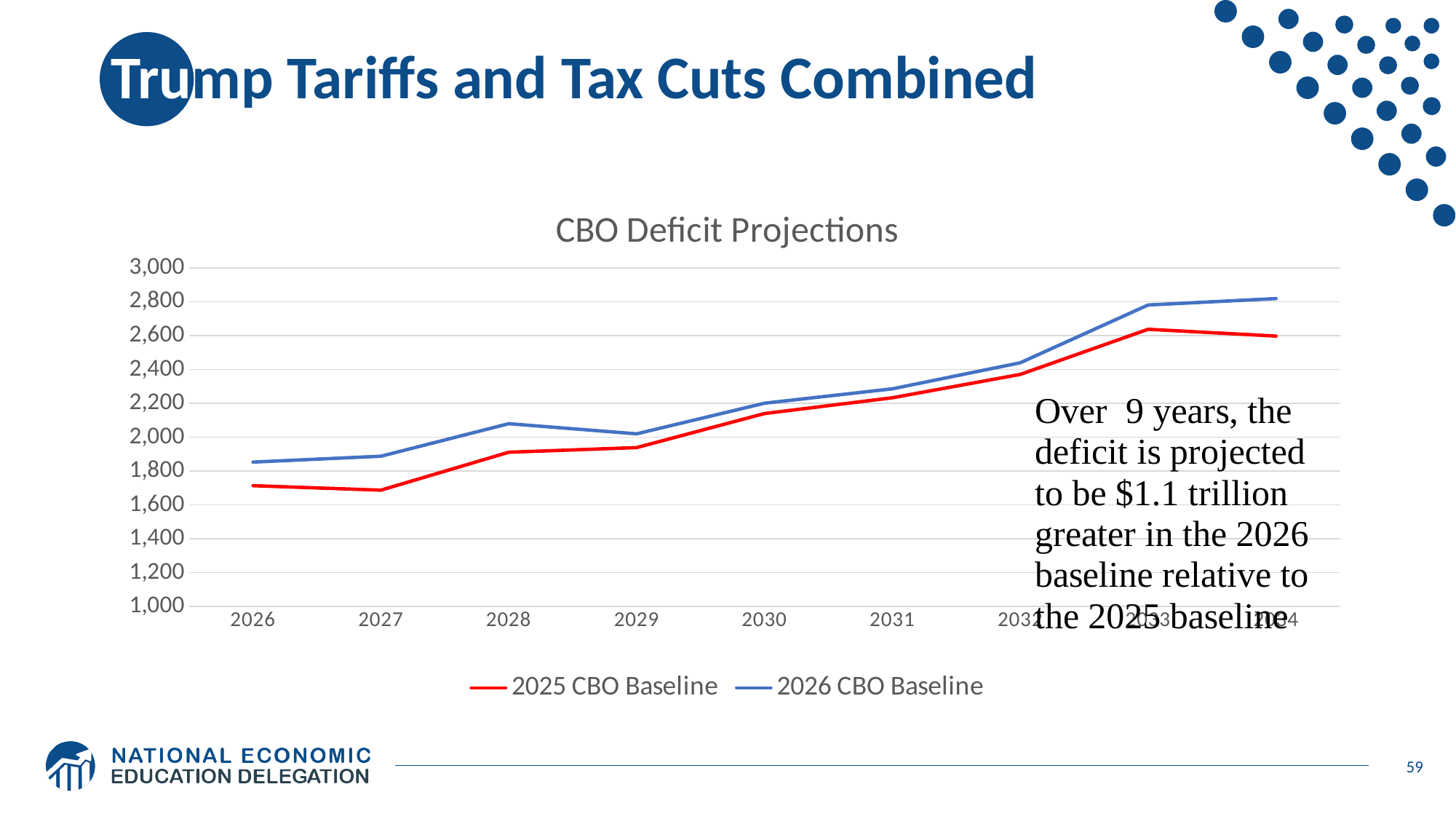
Is the 2026 CBO Baseline value for 2026 greater or less than 1,800? greater Does the 2026 CBO Baseline line generally rise or fall from 2026 to 2034? Rise What is the title of the chart? CBO Deficit Projections In 2030, which series has the higher value, the 2025 CBO Baseline or the 2026 CBO Baseline? 2026 CBO Baseline How many years are plotted along the x axis of the CBO Deficit Projections chart? 9 Which colour is used for the 2026 CBO Baseline line? Blue Is the 2026 CBO Baseline value for 2033 greater or less than 2,600? greater Is the 2026 CBO Baseline value for 2028 greater or less than 2,000? greater What kind of chart is shown on the slide? Line chart How many series does the legend of the CBO Deficit Projections chart list? 2